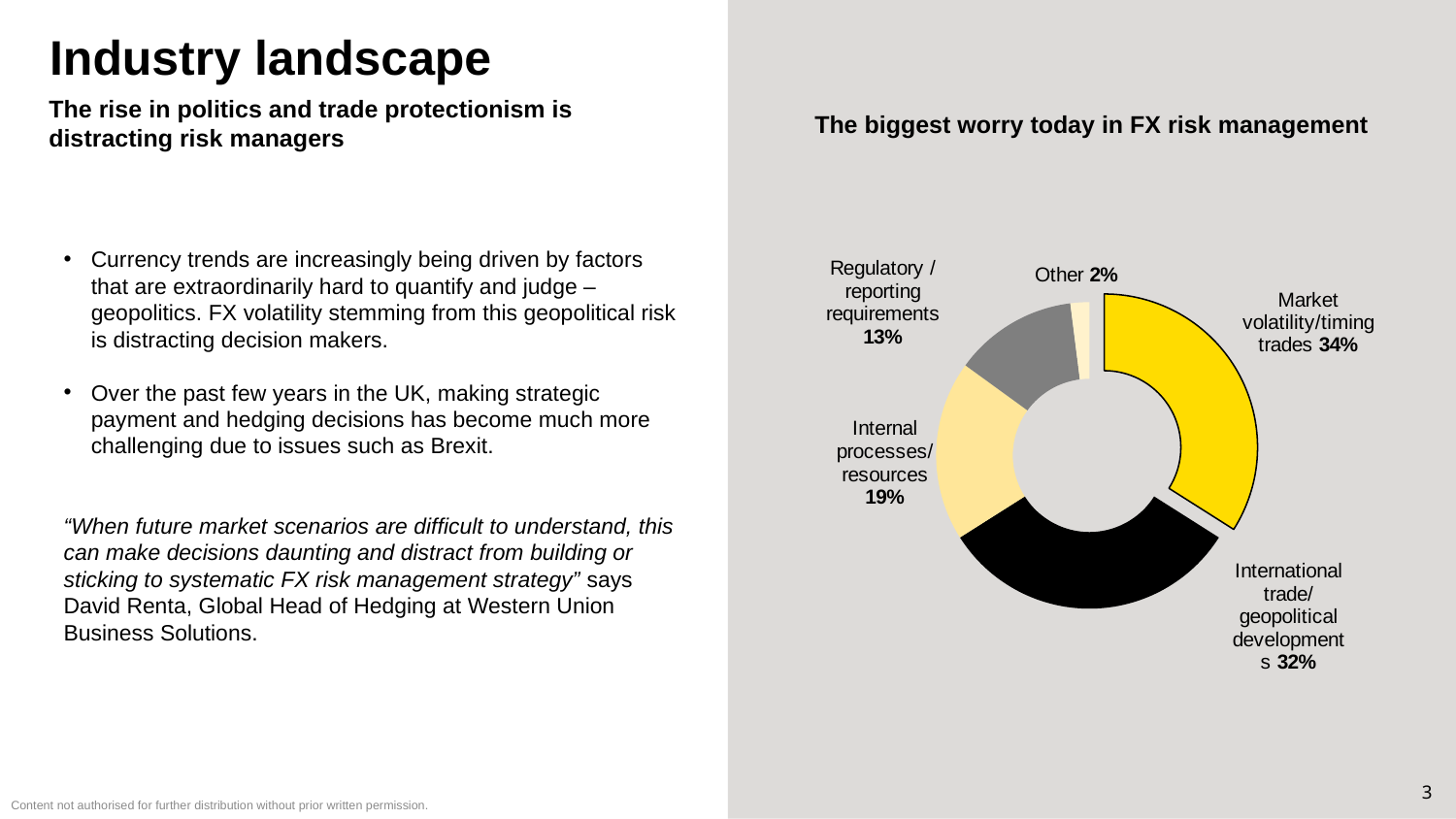
What share of the chart is Regulatory / reporting requirements? 13% Which category has the largest share of the chart? Market volatility/timing trades Which category has the smallest share of the chart? Other What share of the chart is Internal processes/resources? 19% What share of the chart is Other? 2% What kind of chart is shown on the slide? Pie chart (doughnut) What is the title of the chart? The biggest worry today in FX risk management Which is larger, Internal processes/resources or Regulatory / reporting requirements? Internal processes/resources How many categories are shown in the chart? 5 What share of the chart is International trade/geopolitical developments? 32% What share of the chart is Market volatility/timing trades? 34% What is the difference in percentage points between Internal processes/resources and Regulatory / reporting requirements? 6